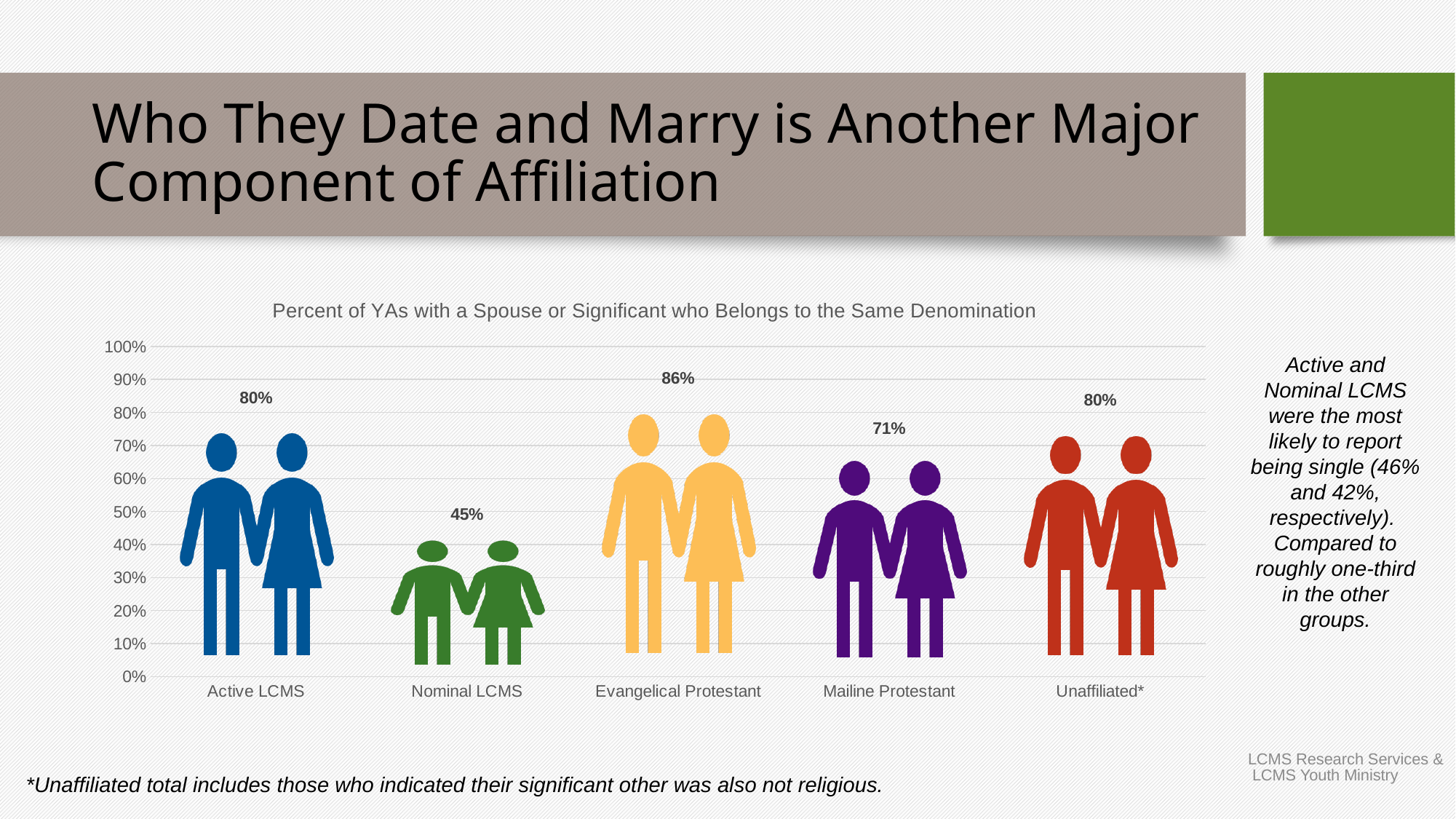
How many categories are shown on the x axis? 5 What is the title of the chart? Percent of YAs with a Spouse or Significant who Belongs to the Same Denomination What is the difference between the values for Evangelical Protestant and Nominal LCMS? 41 percentage points Which category has the highest value? Evangelical Protestant Which is larger, the value for Mailine Protestant or the value for Unaffiliated*? Unaffiliated* What is the value for Evangelical Protestant? 86% Which category has the lowest value? Nominal LCMS What is the value for Active LCMS? 80% What is the value for Unaffiliated*? 80% What colour are the figures for Nominal LCMS? Green What is the value for Nominal LCMS? 45% What is the value for Mailine Protestant? 71%